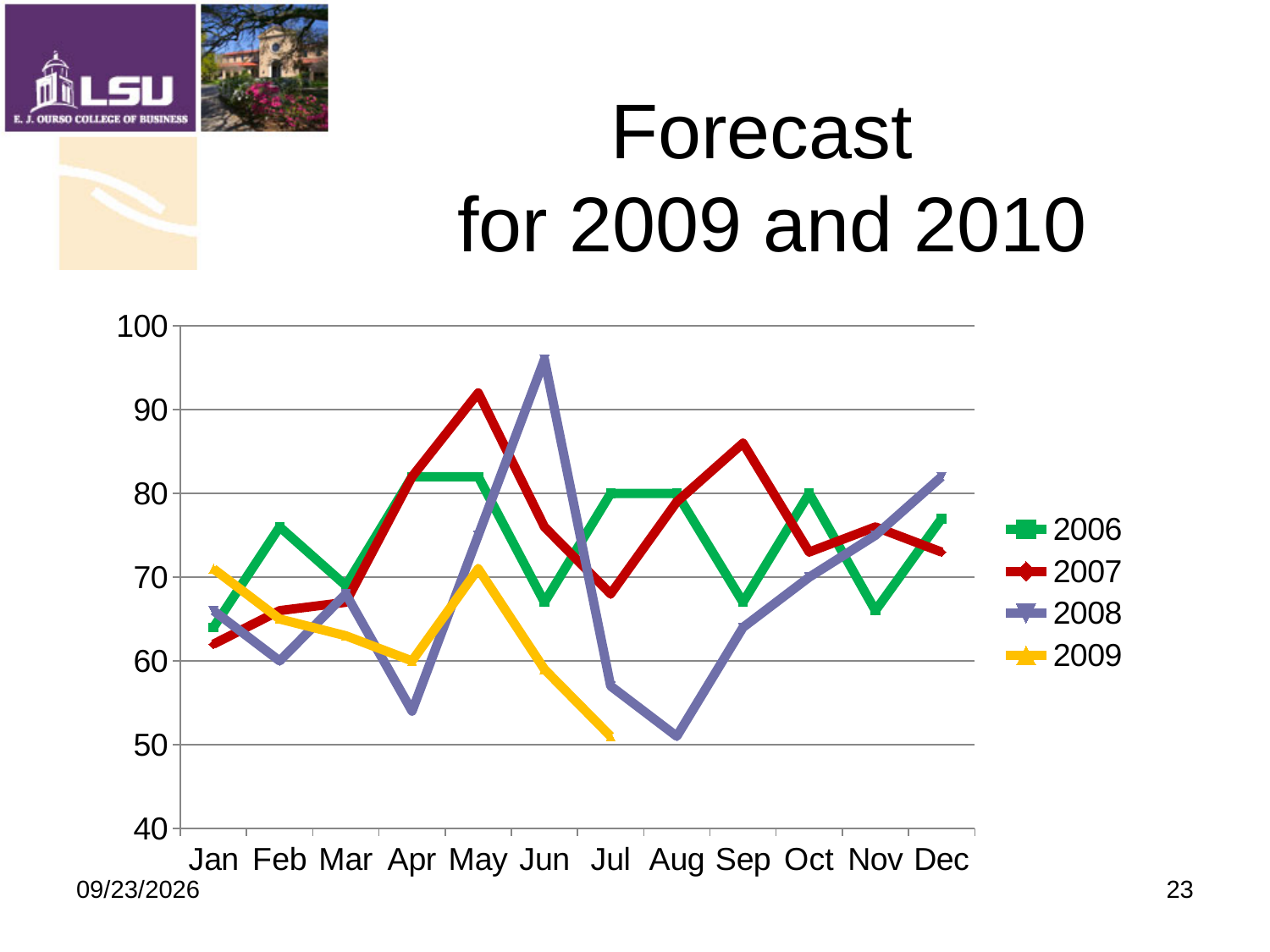
How many months are shown along the x axis? 12 In which month does the 2007 series reach its highest value? May Does the 2009 series rise or fall from May to Jul? fall What kind of chart is shown on the slide? line chart In which month does the 2008 series reach its highest value? Jun Is the value for 2008 in Jun greater or less than 90? greater Is the value for 2008 in Apr greater or less than 60? less In which month does the 2009 series reach its lowest value? Jul In which month does the 2008 series reach its lowest value? Aug How many series does the legend list? 4 Is the value for 2009 in Jul greater or less than 60? less In May, which series has the larger value, 2006 or 2007? 2007